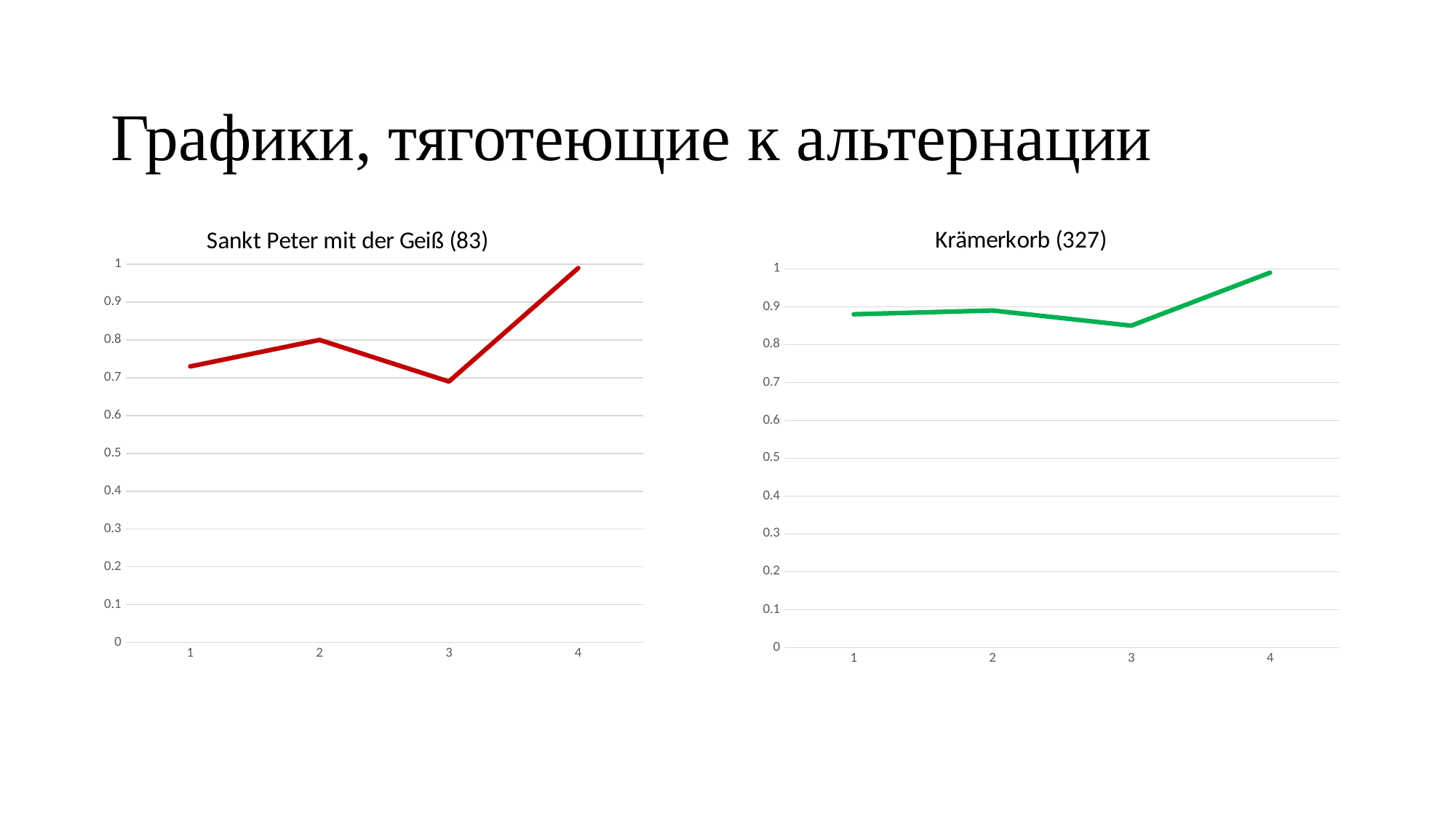
On the 'Sankt Peter mit der Geiß (83)' chart, at which x-axis point is the value highest? 4 On the 'Krämerkorb (327)' chart, is the value at point 1 greater or less than 0.8? greater On the 'Sankt Peter mit der Geiß (83)' chart, is the value at point 4 greater or less than 0.9? greater On the 'Sankt Peter mit der Geiß (83)' chart, does the value rise or fall from point 3 to point 4? rise On the 'Krämerkorb (327)' chart, at which x-axis point is the value highest? 4 On the 'Krämerkorb (327)' chart, which is larger: the value at point 3 or the value at point 4? point 4 On the 'Krämerkorb (327)' chart, is the value at point 3 greater or less than 0.9? less What kind of chart is the 'Sankt Peter mit der Geiß (83)' chart? line chart On the 'Sankt Peter mit der Geiß (83)' chart, which is larger: the value at point 2 or the value at point 1? point 2 How many points are plotted on the 'Krämerkorb (327)' chart? 4 What colour is the line on the 'Krämerkorb (327)' chart? green